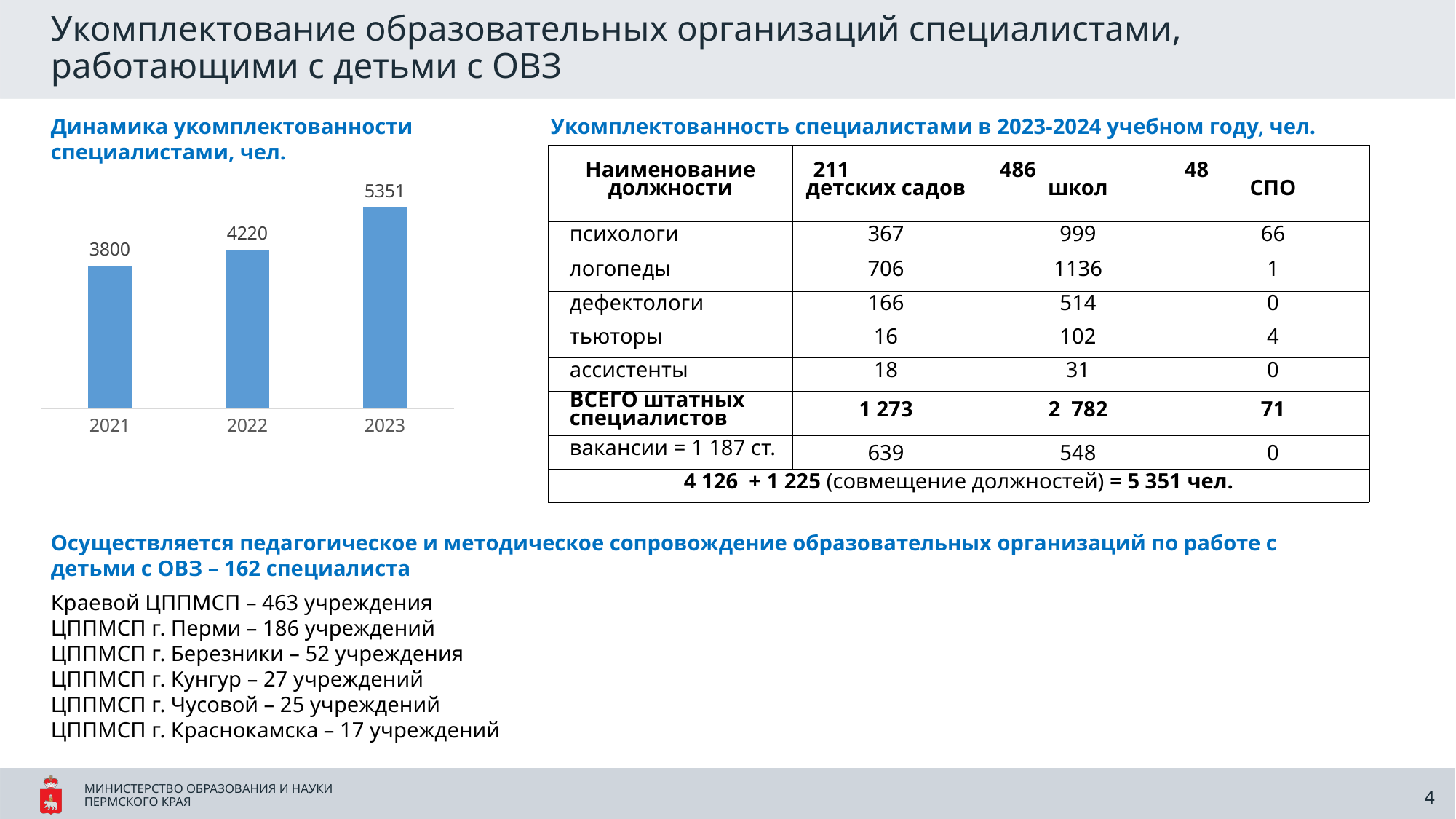
What is the value for 2022 in the chart 'Динамика укомплектованности специалистами, чел.'? 4220 What kind of chart is 'Динамика укомплектованности специалистами, чел.'? bar chart Which year has the highest value in the chart 'Динамика укомплектованности специалистами, чел.'? 2023 What is the value for 2021 in the chart 'Динамика укомплектованности специалистами, чел.'? 3800 What is the difference between the 2022 and 2021 values in the chart 'Динамика укомплектованности специалистами, чел.'? 420 In the chart 'Динамика укомплектованности специалистами, чел.', which is larger: the value for 2022 or the value for 2023? 2023 What is the difference between the 2023 and 2021 values in the chart 'Динамика укомплектованности специалистами, чел.'? 1551 What is the title of the bar chart on the left of the slide? Динамика укомплектованности специалистами, чел. How many years are shown in the chart 'Динамика укомплектованности специалистами, чел.'? 3 Which year has the lowest value in the chart 'Динамика укомплектованности специалистами, чел.'? 2021 What is the value for 2023 in the chart 'Динамика укомплектованности специалистами, чел.'? 5351 Do the values in the chart 'Динамика укомплектованности специалистами, чел.' rise or fall from 2021 to 2023? rise